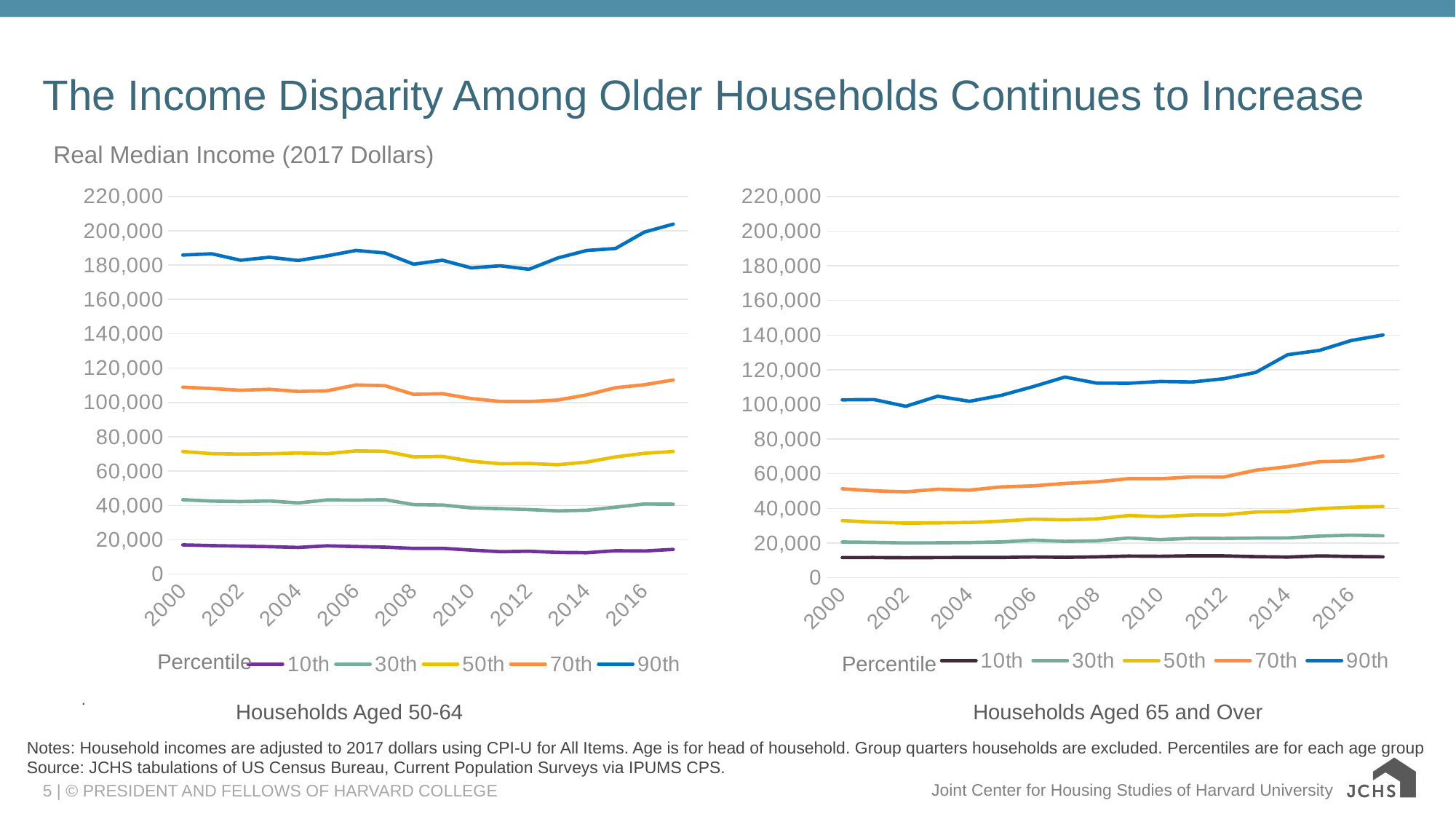
In the 'Households Aged 50-64' chart, is the 10th percentile value in 2017 greater or less than 20,000? less In the 'Households Aged 50-64' chart, is the 70th percentile value in 2017 greater or less than 100,000? greater In the 'Households Aged 65 and Over' chart, is the 10th percentile value in 2017 greater or less than 20,000? less What is the subtitle shown above the charts describing the measure plotted? Real Median Income (2017 Dollars) What kind of chart is the 'Households Aged 50-64' chart? line chart Which is larger in 2017: the 90th percentile value for Households Aged 50-64 or the 90th percentile value for Households Aged 65 and Over? Households Aged 50-64 How many series does the legend of the 'Households Aged 65 and Over' chart list? 5 What colour is the 90th percentile line in the 'Households Aged 65 and Over' chart? blue In the 'Households Aged 50-64' chart, which percentile series has the lowest values? 10th In the 'Households Aged 65 and Over' chart, does the 90th percentile line rise or fall overall from 2000 to 2017? rise